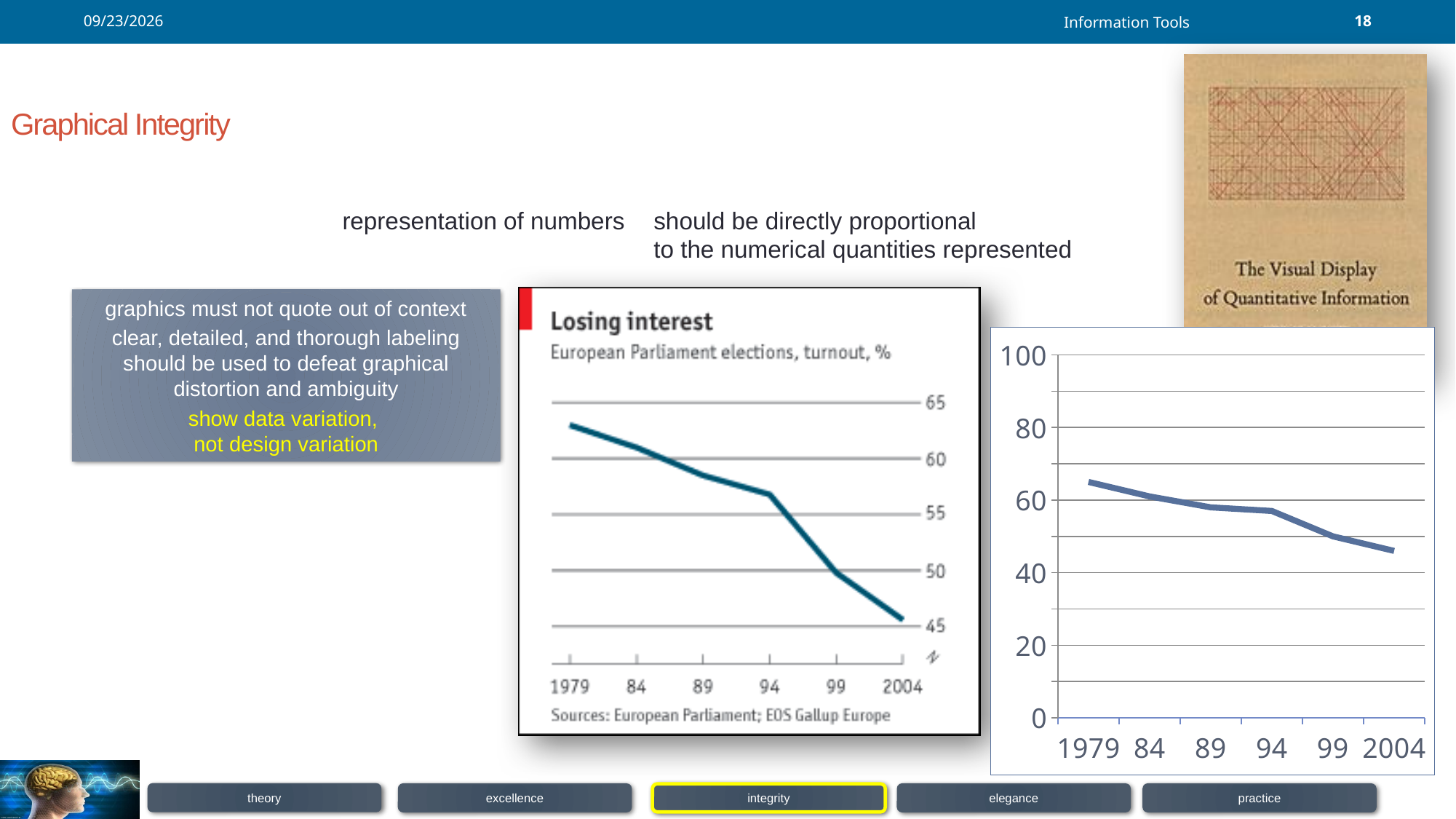
What kind of chart is the "Losing interest" chart? line chart In the "Losing interest" chart, is the turnout for 1979 greater or less than 60? greater In the "Losing interest" chart, do the turnout values rise or fall from 1979 to 2004? fall In the "Losing interest" chart, is the turnout for 2004 greater or less than 50? less How many years are labelled on the x axis of the "Losing interest" chart? 6 In the "Losing interest" chart, which is larger, the turnout for 84 or for 94? 84 In the "Losing interest" chart, which year has the lowest turnout? 2004 In the chart on the right of the slide, is the value for 2004 greater or less than 60? less In the "Losing interest" chart, which year has the highest turnout? 1979 What is the subtitle under the "Losing interest" chart title? European Parliament elections, turnout, %